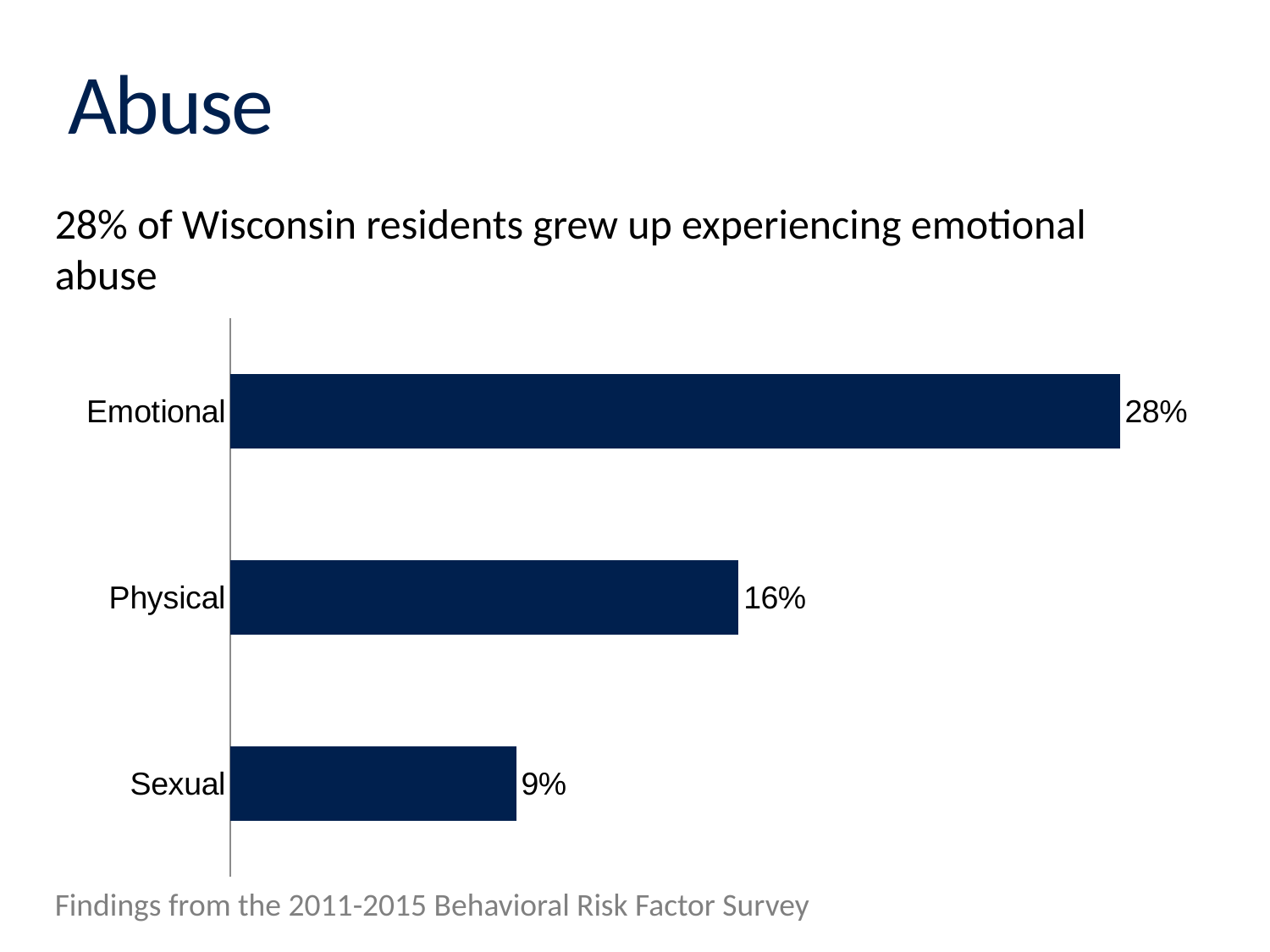
What percentage of Wisconsin residents experienced emotional abuse growing up, according to the chart? 28% How many categories of abuse are shown on the chart? 3 What kind of chart is shown on the slide? Bar chart What is the difference in percentage points between Emotional and Physical abuse? 12 What is the value shown for Physical abuse? 16% What is the value shown for Sexual abuse? 9% Which is larger, the value for Physical abuse or the value for Sexual abuse? Physical What is the title of the slide containing the chart? Abuse Which type of abuse has the highest percentage on the chart? Emotional Which type of abuse has the lowest percentage on the chart? Sexual What is the difference in percentage points between Physical and Sexual abuse? 7 What survey is cited as the source of the chart's findings? 2011-2015 Behavioral Risk Factor Survey